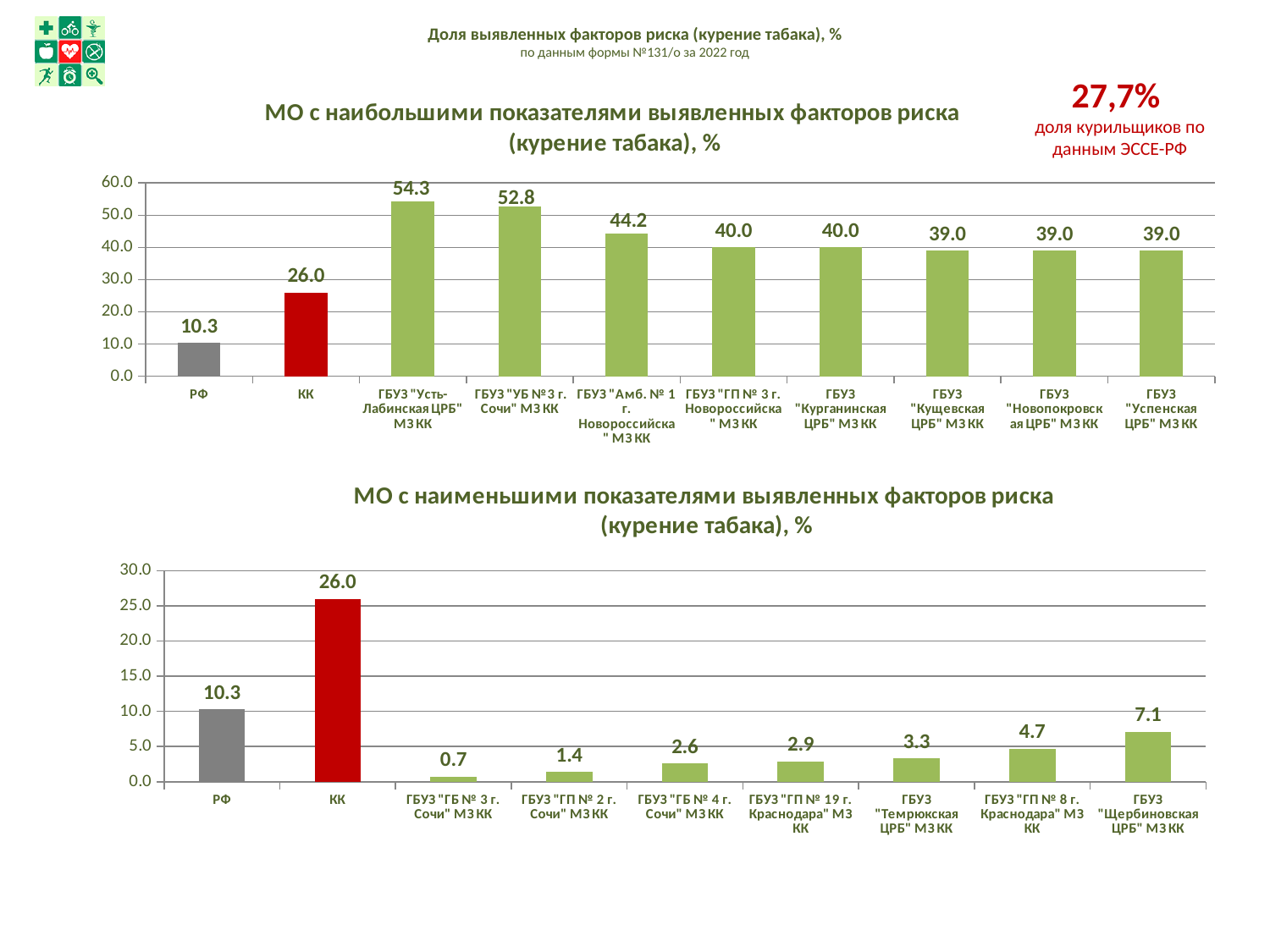
What type of chart is the bottom chart (МО с наименьшими показателями)? Bar chart In the bottom chart (МО с наименьшими показателями), which category has the lowest value? ГБУЗ "ГБ № 3 г. Сочи" МЗ КК In the top chart (МО с наибольшими показателями), how many categories are shown on the x axis? 10 In the top chart (МО с наибольшими показателями), what is the difference between ГБУЗ "Усть-Лабинская ЦРБ" МЗ КК and ГБУЗ "УБ №3 г. Сочи" МЗ КК? 1.5 In the top chart (МО с наибольшими показателями), which category has the highest value? ГБУЗ "Усть-Лабинская ЦРБ" МЗ КК In the bottom chart (МО с наименьшими показателями), which is larger: ГБУЗ "ГП № 8 г. Краснодара" МЗ КК or ГБУЗ "Щербиновская ЦРБ" МЗ КК? ГБУЗ "Щербиновская ЦРБ" МЗ КК In the top chart (МО с наибольшими показателями), what is the difference between КК and РФ? 15.7 In the top chart (МО с наибольшими показателями), what is the value for ГБУЗ "Амб. № 1 г. Новороссийска" МЗ КК? 44.2 In the bottom chart (МО с наименьшими показателями), how many categories are shown on the x axis? 9 In the bottom chart (МО с наименьшими показателями), what is the value for ГБУЗ "Темрюкская ЦРБ" МЗ КК? 3.3 In the top chart (МО с наибольшими показателями), what colour is the bar for КК? Red In the top chart (МО с наибольшими показателями), what is the value for ГБУЗ "Усть-Лабинская ЦРБ" МЗ КК? 54.3